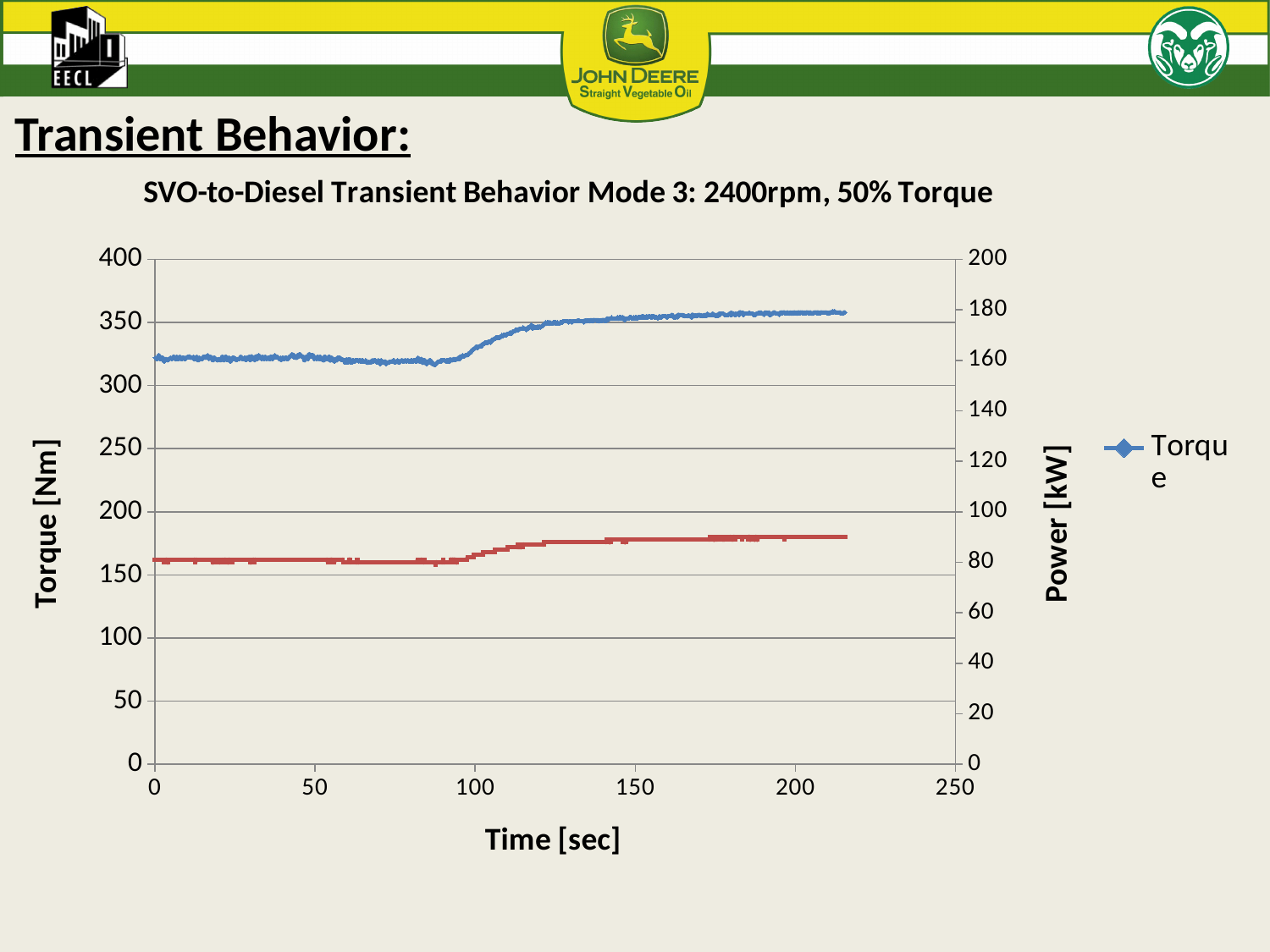
What kind of chart is shown on the slide? line chart Does the red line rise or fall overall as time increases? rise Is the Torque value at time 200 sec greater or less than 400? less Does the Torque line rise or fall overall as time increases? rise What is the title of the chart? SVO-to-Diesel Transient Behavior Mode 3: 2400rpm, 50% Torque How many lines are plotted on the chart? 2 Is the Torque value at time 50 sec greater or less than 350? less Is the Torque value at time 150 sec greater or less than 300? greater What is the label of the left vertical axis? Torque [Nm] Which is larger, the Torque value at 50 sec or at 200 sec? 200 sec How many series does the chart legend list? 1